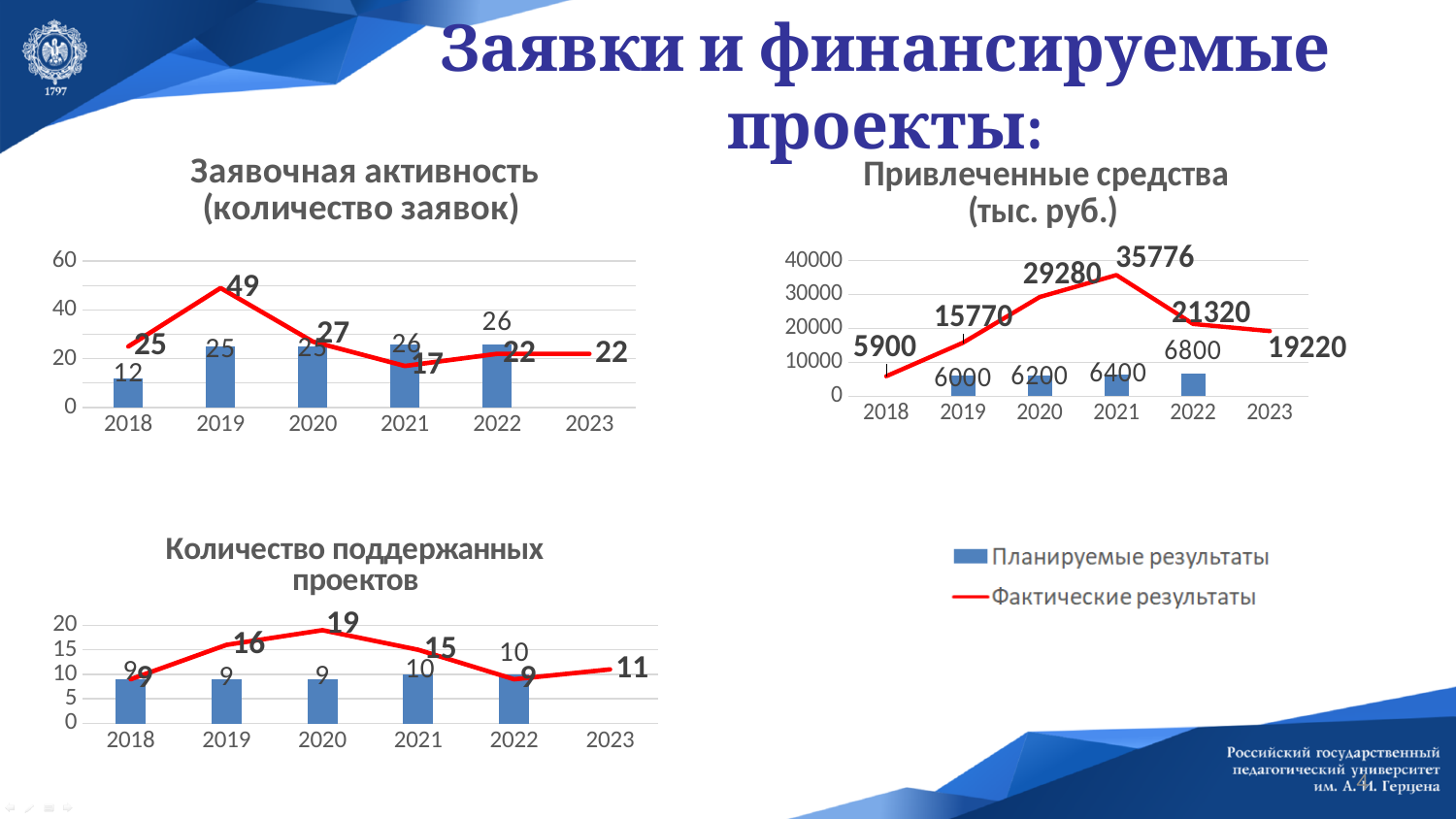
In the 'Привлеченные средства (тыс. руб.)' chart, do the actual values rise or fall from 2021 to 2023? fall In the 'Привлеченные средства (тыс. руб.)' chart, which year has the highest actual (line) value? 2021 In the 'Привлеченные средства (тыс. руб.)' chart, what is the difference between the actual and planned values for 2021? 29376 How many years are shown on the x axis of the 'Количество поддержанных проектов' chart? 6 In the 'Количество поддержанных проектов' chart, what is the actual (line) value for 2020? 19 How many series does the legend on the slide list? 2 In the 'Заявочная активность (количество заявок)' chart, which year has the lowest actual (line) value? 2021 What kind of chart is the 'Заявочная активность (количество заявок)' chart? Combined bar and line chart In the 'Заявочная активность (количество заявок)' chart, is the actual value for 2019 larger or smaller than the planned value for 2019? larger In the 'Заявочная активность (количество заявок)' chart, what is the actual (Фактические результаты) value for 2019? 49 In the 'Привлеченные средства (тыс. руб.)' chart, what is the planned (bar) value for 2019? 6000 In the 'Количество поддержанных проектов' chart, what is the difference between the actual and planned values for 2020? 10